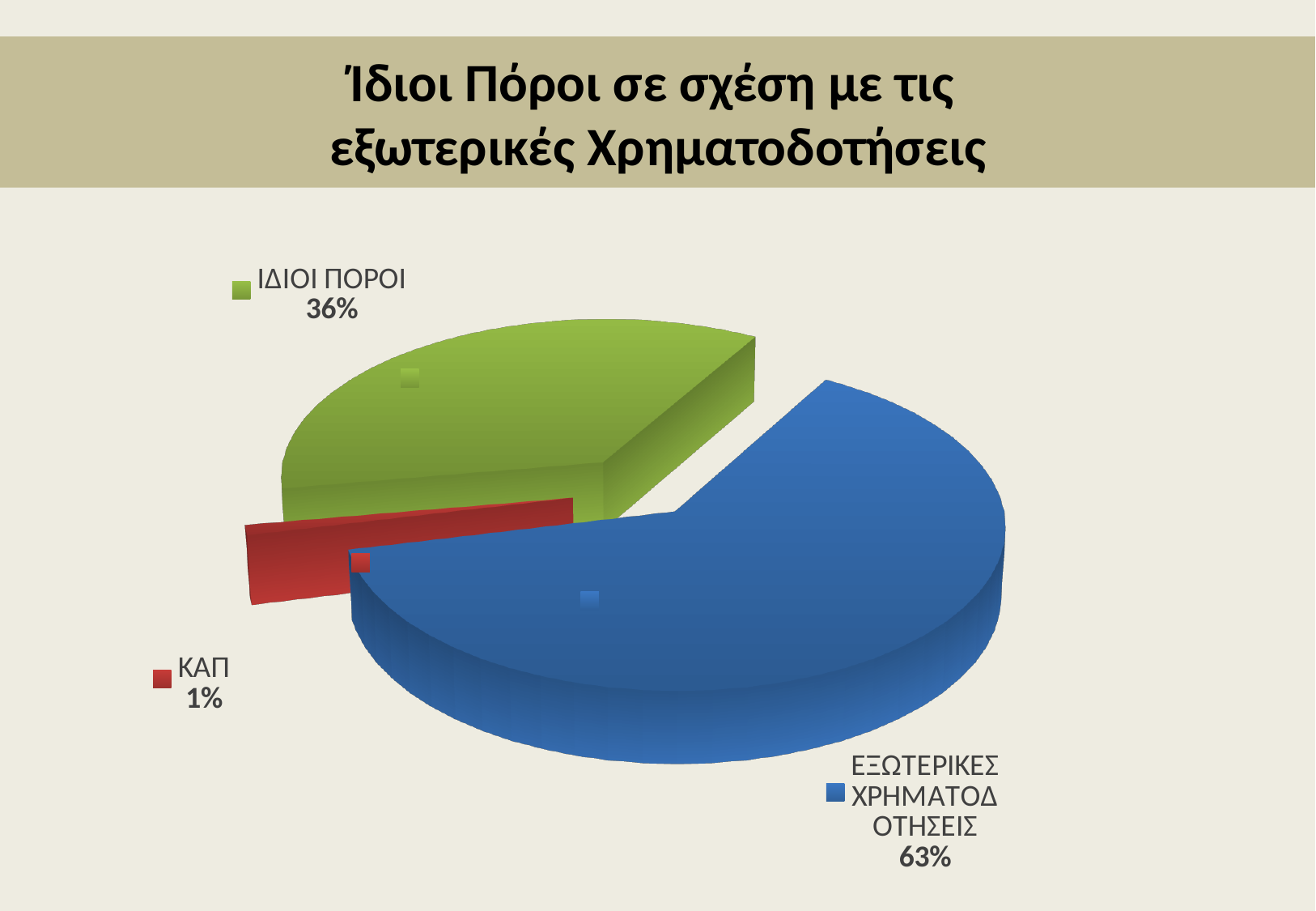
What share of the pie does ΕΞΩΤΕΡΙΚΕΣ ΧΡΗΜΑΤΟΔΟΤΗΣΕΙΣ represent? 63% Which is larger, ΙΔΙΟΙ ΠΟΡΟΙ or ΚΑΠ? ΙΔΙΟΙ ΠΟΡΟΙ What share of the pie does ΙΔΙΟΙ ΠΟΡΟΙ represent? 36% What colour is the slice for ΙΔΙΟΙ ΠΟΡΟΙ? Green Which category has the smallest slice of the pie? ΚΑΠ What is the value shown for ΚΑΠ? 1% What is the title of the chart? Ίδιοι Πόροι σε σχέση με τις εξωτερικές Χρηματοδοτήσεις What is the difference in percentage points between ΙΔΙΟΙ ΠΟΡΟΙ and ΚΑΠ? 35% How many categories are shown in the pie chart? 3 Which category has the largest slice of the pie? ΕΞΩΤΕΡΙΚΕΣ ΧΡΗΜΑΤΟΔΟΤΗΣΕΙΣ What is the difference in percentage points between ΕΞΩΤΕΡΙΚΕΣ ΧΡΗΜΑΤΟΔΟΤΗΣΕΙΣ and ΙΔΙΟΙ ΠΟΡΟΙ? 27% What kind of chart is shown on the slide? Pie chart